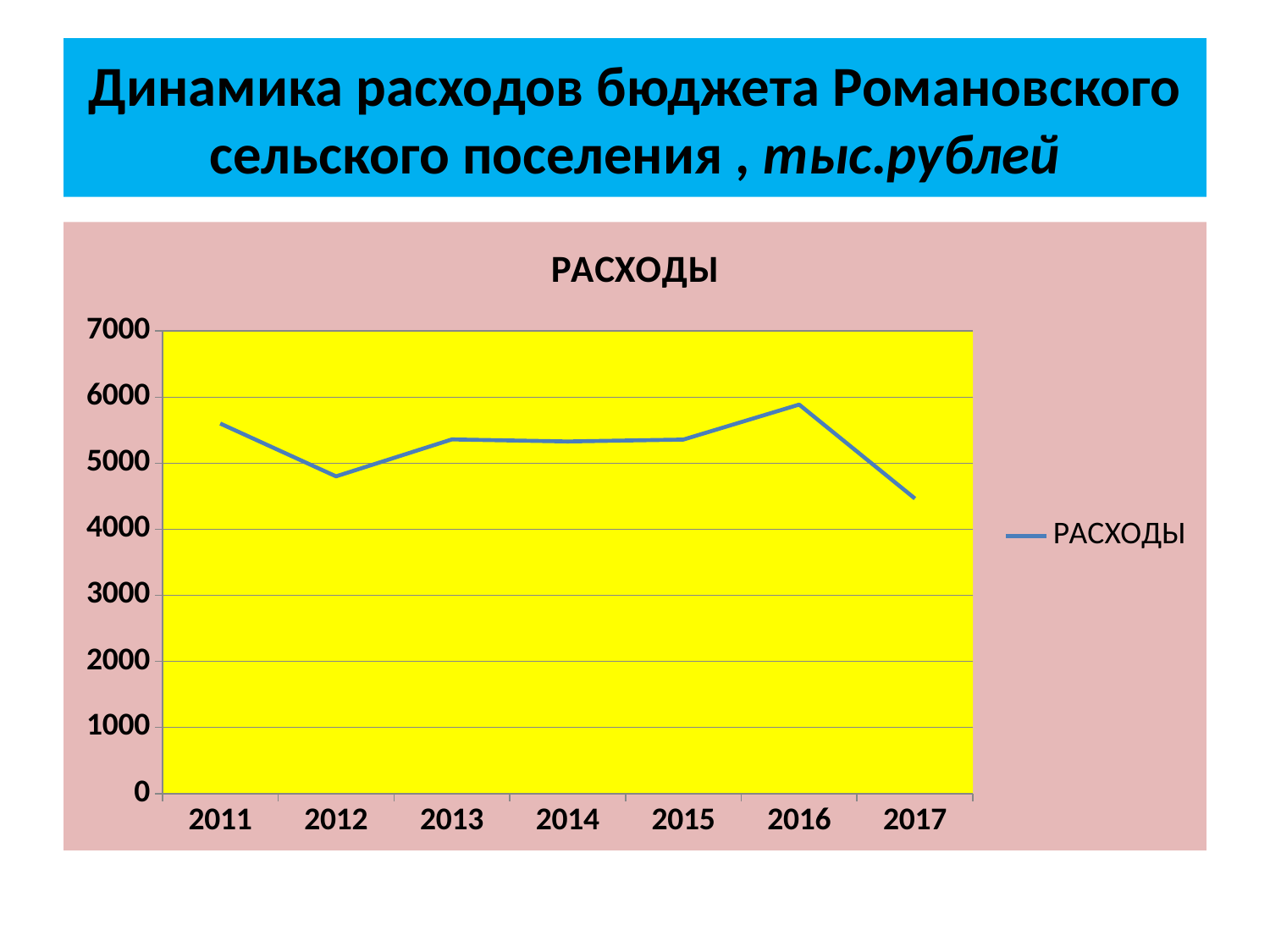
How many years are plotted on the x axis of the chart? 7 In which year is the value of РАСХОДЫ lowest? 2017 How many series does the legend of the chart list? 1 Does the value rise or fall from 2016 to 2017? fall In which year is the value of РАСХОДЫ highest? 2016 Which year has the larger value, 2012 or 2016? 2016 Is the value for 2017 greater or less than 5000? less What is the title of the chart? РАСХОДЫ Is the value for 2011 greater or less than 5000? greater Is the value for 2016 greater or less than 5000? greater What kind of chart is shown on the slide? line chart